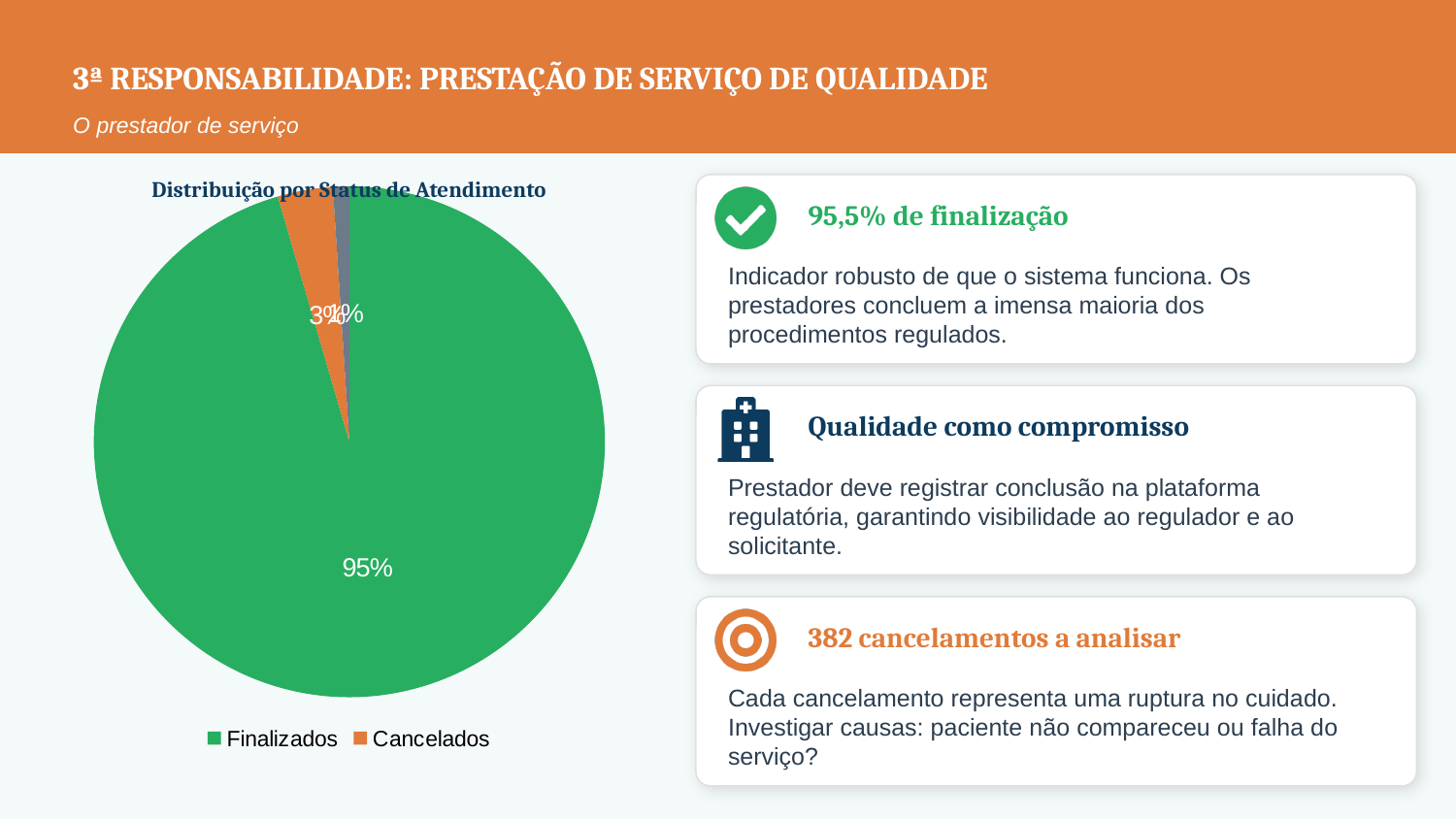
How many entries does the chart legend list? 2 What colour is used for the Cancelados slice? orange Which of the two legend categories, Finalizados or Cancelados, has the smaller slice? Cancelados What is the title of the chart? Distribuição por Status de Atendimento Which is larger, the Finalizados slice or the Cancelados slice? Finalizados What kind of chart is shown on the slide? pie chart Which category has the largest slice of the pie? Finalizados What percentage of the pie does the Finalizados slice represent? 95%